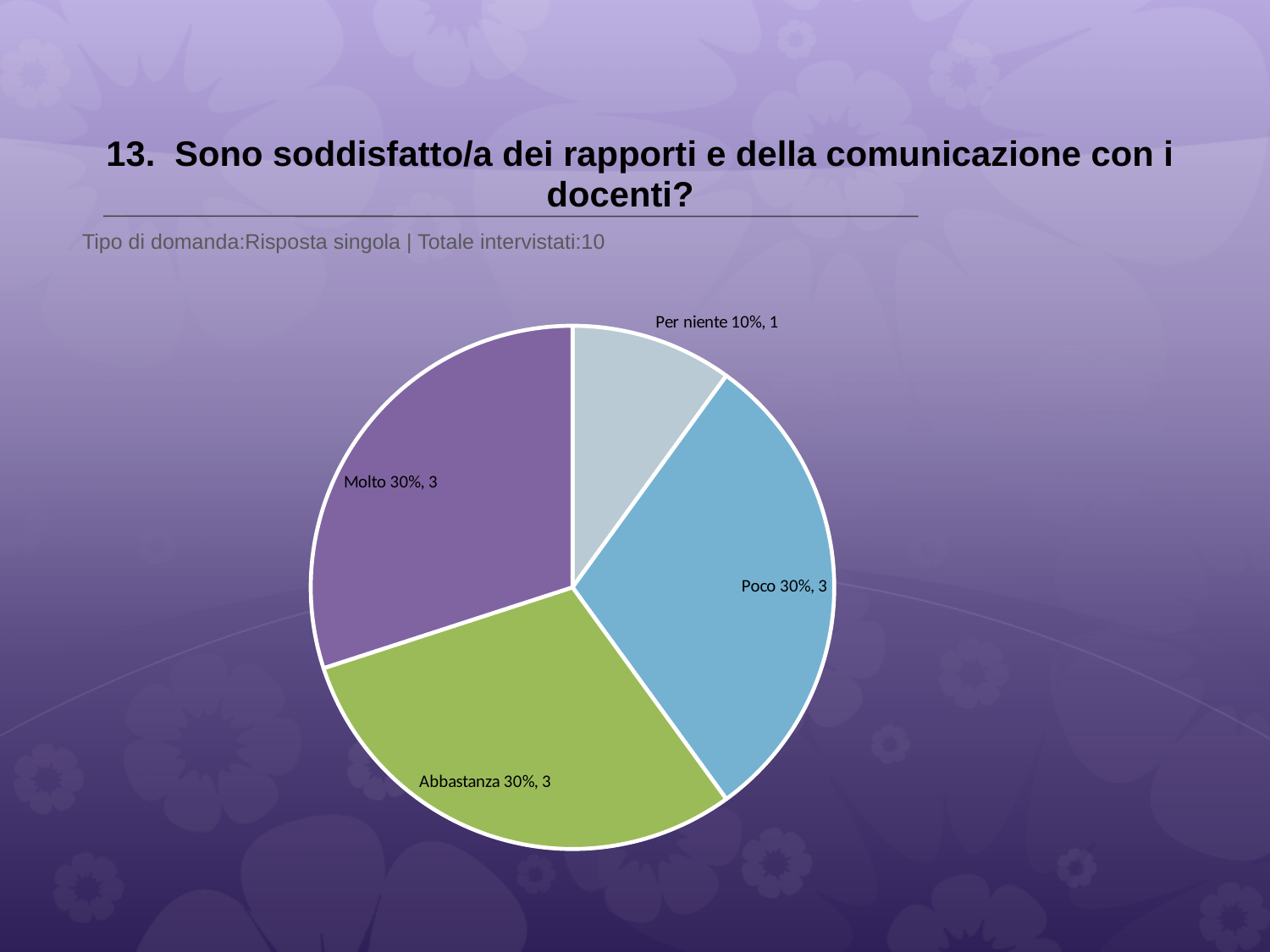
What is the total number of respondents shown on the slide? 10 What is the title of the chart on the slide? 13. Sono soddisfatto/a dei rapporti e della comunicazione con i docenti? What kind of chart is shown on the slide? pie chart How many slices does the pie chart have? 4 What is the difference in respondents between "Molto" and "Per niente"? 2 What percentage share does the "Per niente" slice have? 10% How many respondents answered "Per niente"? 1 Which is larger, the "Poco" slice or the "Per niente" slice? Poco What percentage share does the "Poco" slice have? 30% How many respondents answered "Molto"? 3 Which category has the smallest slice of the pie? Per niente How many respondents answered "Abbastanza"? 3